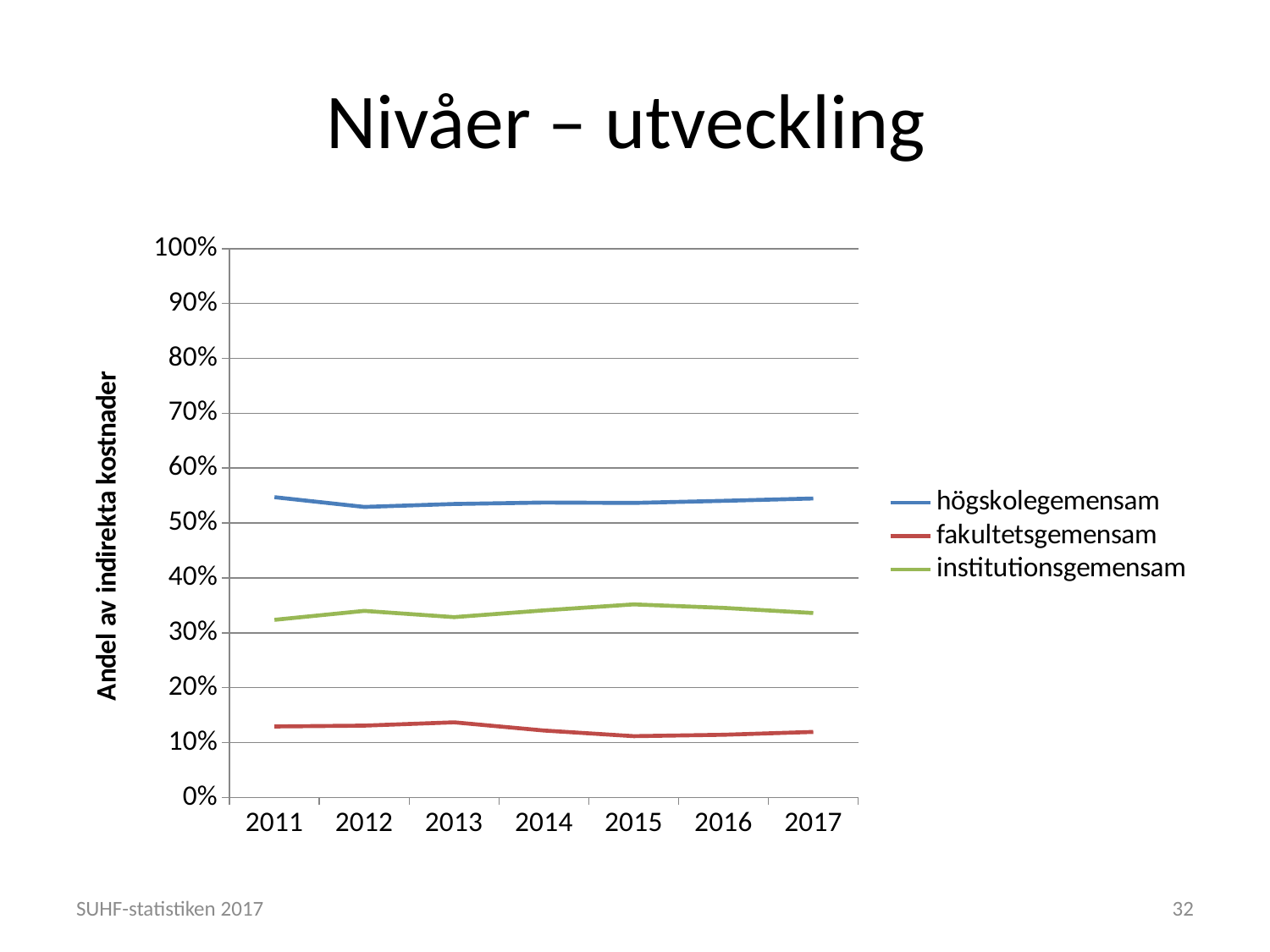
How many series does the legend list? 3 What kind of chart is shown on the slide? line chart In 2017, which is larger: institutionsgemensam or fakultetsgemensam? institutionsgemensam Is the value for högskolegemensam in 2011 greater or less than 50%? greater Is the value for institutionsgemensam in 2015 greater or less than 30%? greater Is the value for högskolegemensam in 2012 greater or less than 60%? less What is the label on the y axis? Andel av indirekta kostnader Which series has the lowest values throughout the chart? fakultetsgemensam What is the title of the slide? Nivåer – utveckling Which series has the highest values throughout the chart? högskolegemensam How many years are shown on the x axis? 7